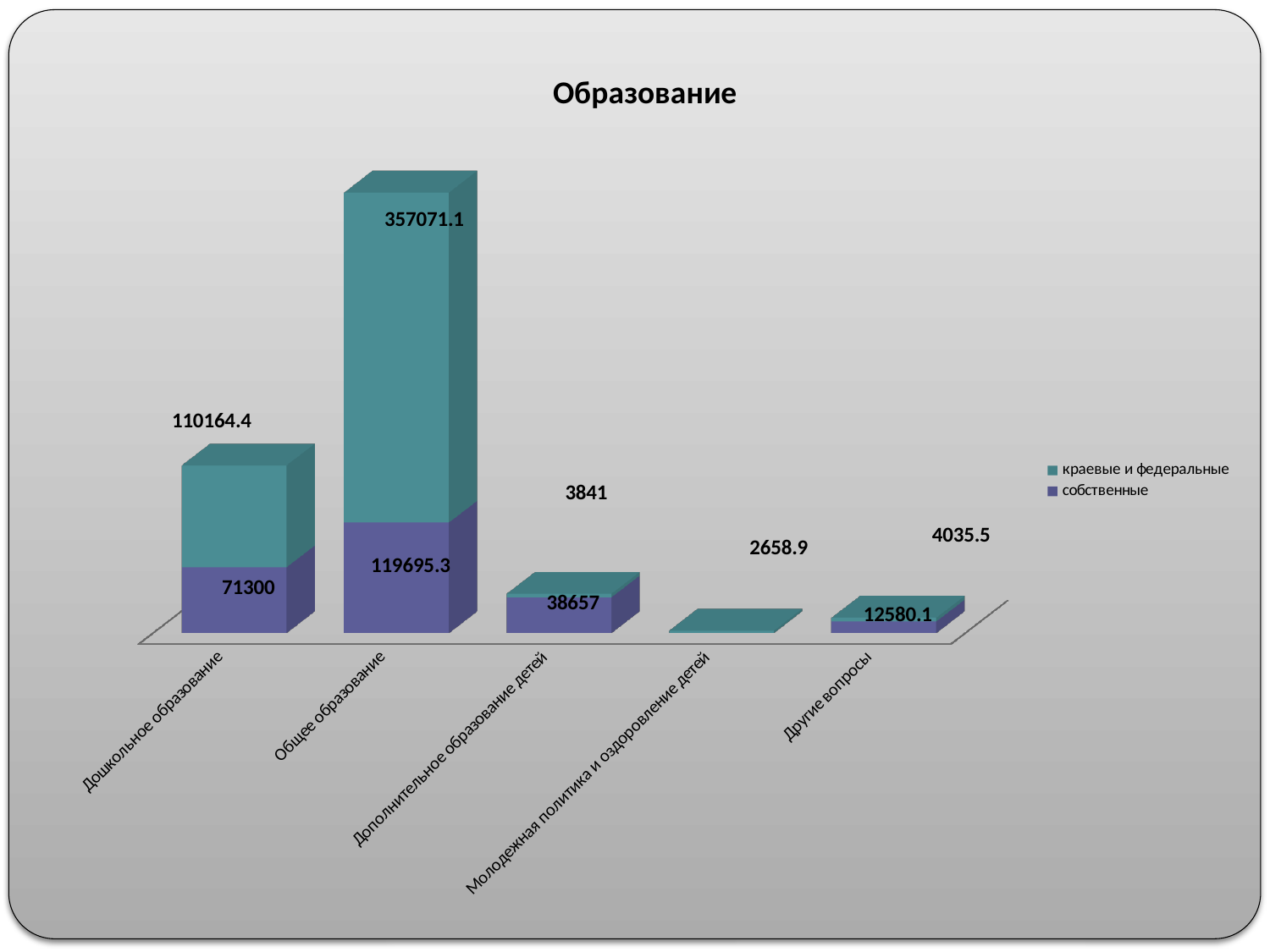
What type of chart is shown on the slide? bar chart Which category has the highest value for 'краевые и федеральные'? Общее образование What is the total of the stacked bar for 'Дополнительное образование детей'? 42498 How many series does the legend list? 2 Which is larger for 'Дошкольное образование': 'краевые и федеральные' or 'собственные'? краевые и федеральные What is the value of 'собственные' for 'Дошкольное образование'? 71300 How many categories are shown on the x axis? 5 What is the difference between 'краевые и федеральные' and 'собственные' for 'Общее образование'? 237375.8 What is the value of 'краевые и федеральные' for 'Общее образование'? 357071.1 What is the value of 'собственные' for 'Другие вопросы'? 12580.1 What is the value of 'краевые и федеральные' for 'Молодежная политика и оздоровление детей'? 2658.9 What is the title of the chart? Образование